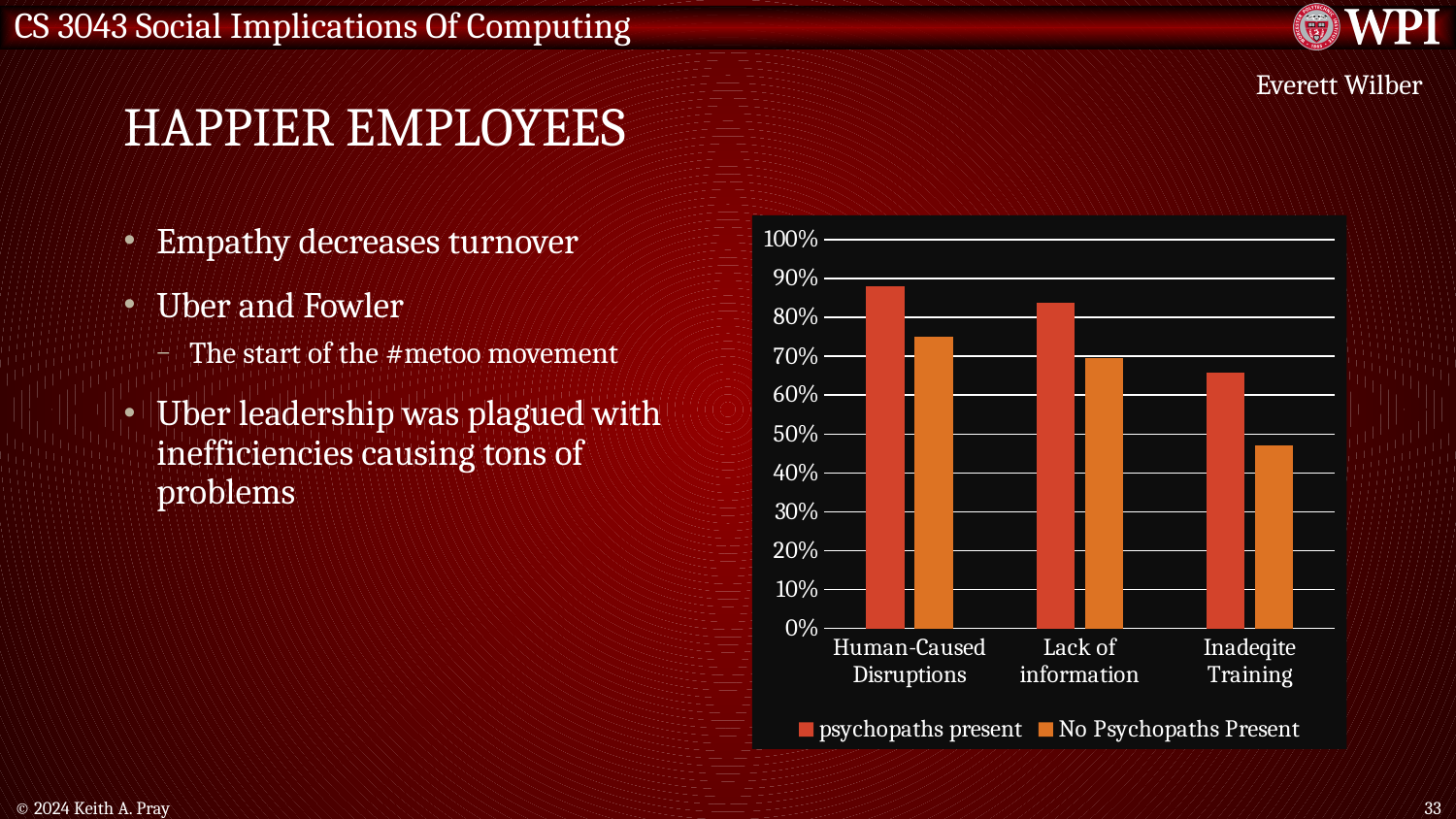
Which category has the lowest value for the 'No Psychopaths Present' series? Inadeqite Training Is the 'No Psychopaths Present' value for Inadeqite Training greater or less than 50%? less What kind of chart is shown on the slide? Bar chart How many series does the chart's legend list? 2 How many categories are shown on the x axis of the chart? 3 Is the 'psychopaths present' value for Human-Caused Disruptions greater or less than 80%? greater What are the two series names listed in the chart's legend? psychopaths present; No Psychopaths Present Is the 'psychopaths present' value for Inadeqite Training greater or less than 60%? greater Which category has the highest value for the 'psychopaths present' series? Human-Caused Disruptions For 'Lack of information', which series has the larger value: 'psychopaths present' or 'No Psychopaths Present'? psychopaths present Do the 'psychopaths present' values rise or fall moving from Human-Caused Disruptions to Inadeqite Training along the x axis? fall